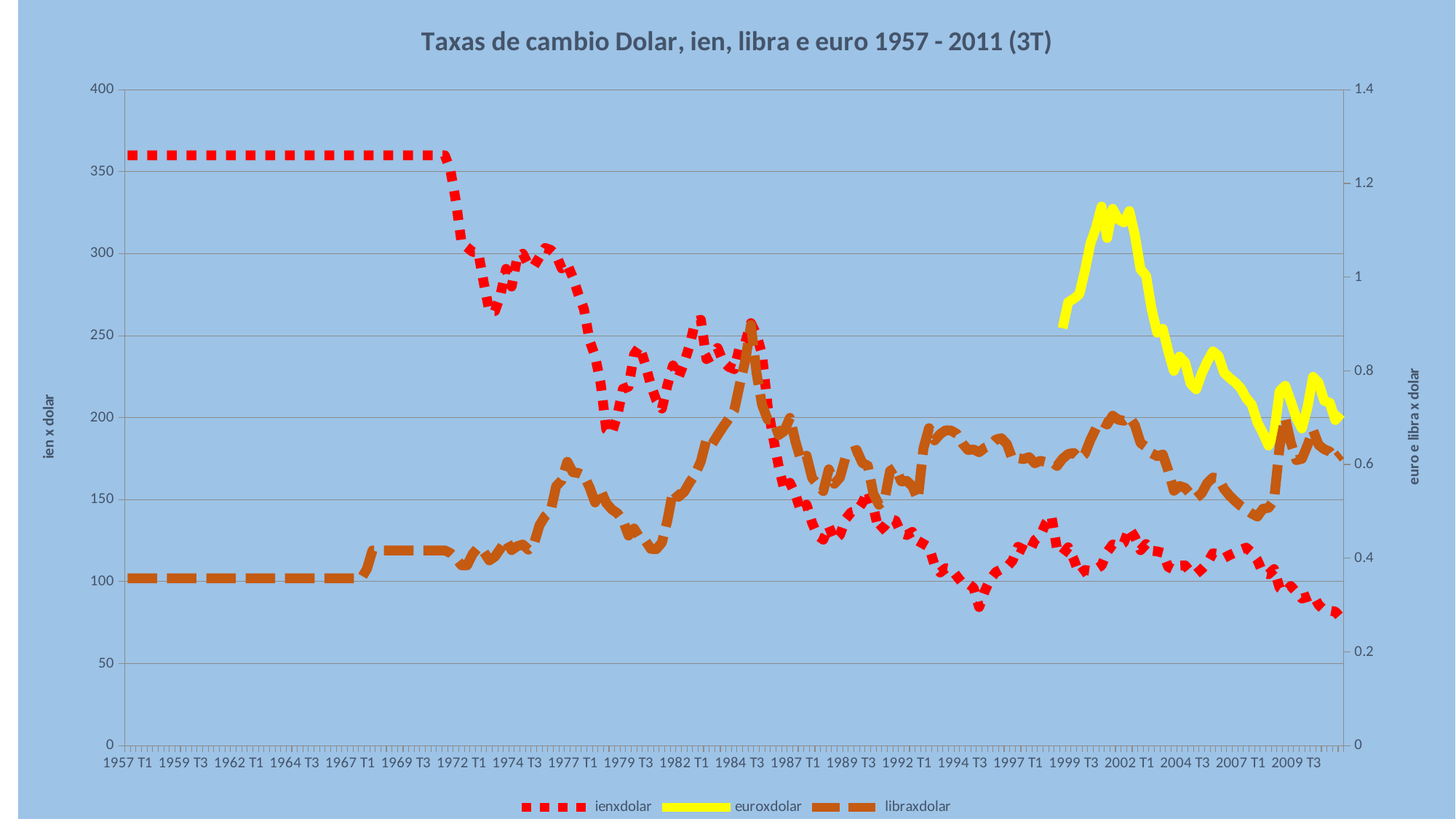
Is the value of libraxdolar in 1957 greater or less than 0.4? less Which series is drawn as a solid yellow line? euroxdolar Is the peak value of euroxdolar around 2001-2002 greater or less than 1? greater How many series does the legend list? 3 Is the value of ienxdolar in 1957 greater or less than 350? greater What kind of chart is shown on the slide? line chart Does the ienxdolar series overall rise or fall from 1957 to 2011? fall What is the title of the chart? Taxas de cambio Dolar, ien, libra e euro 1957 - 2011 (3T) Does the euroxdolar series rise or fall from its 2002 peak to 2011? fall Which is larger for ienxdolar: the value in 1957 or the value in 2011? 1957 What is the label of the right-hand vertical axis? euro e libra x dolar